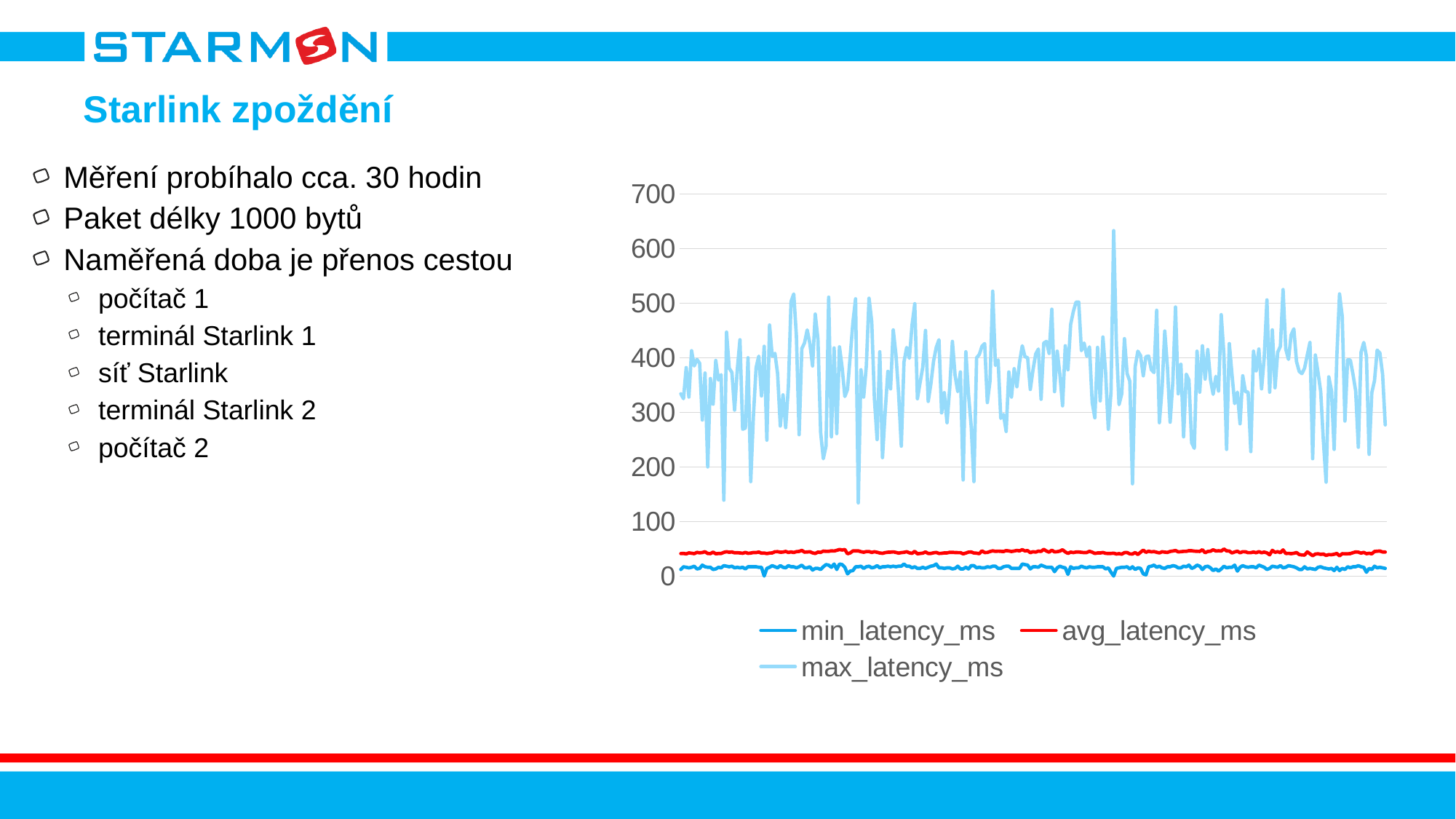
Is the min_latency_ms series greater or less than 100 across the chart? less Which series is larger, avg_latency_ms or min_latency_ms? avg_latency_ms Is the highest peak of the max_latency_ms series greater or less than 600? greater What kind of chart is shown on the slide? line chart Which series in the chart has the highest values throughout? max_latency_ms How many series does the chart legend list? 3 Is the avg_latency_ms series greater or less than 100 across the chart? less What colour is the avg_latency_ms series drawn in? red Which series in the chart has the lowest values throughout? min_latency_ms What is the highest value shown on the chart's vertical axis? 700 Does the avg_latency_ms series show a strong rising or falling trend along the x axis, or stay roughly flat? roughly flat